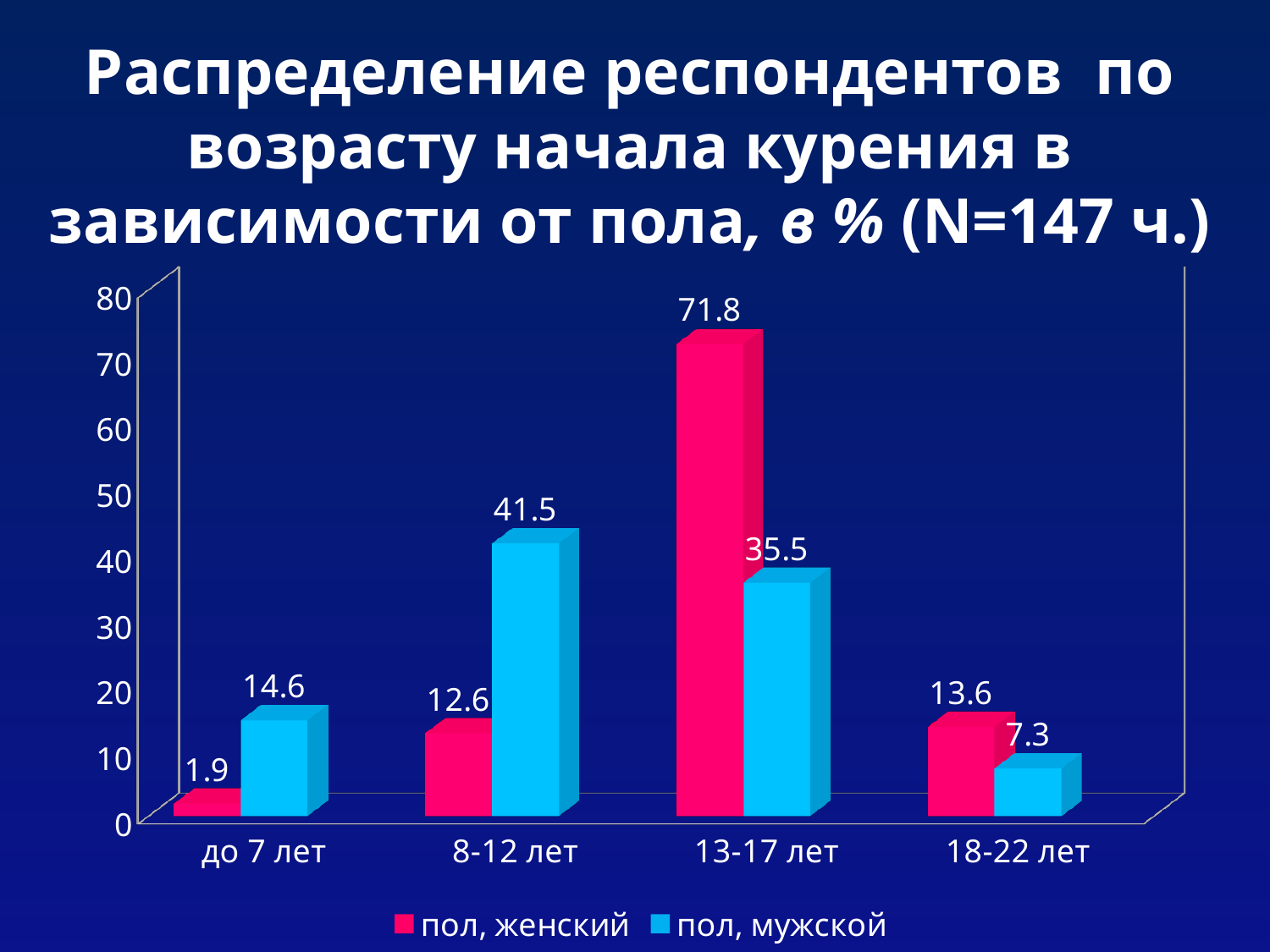
Which category has the highest value for 'пол, мужской'? 8-12 лет How many age categories are shown on the x axis? 4 What kind of chart is shown on the slide? bar chart What colour are the bars for 'пол, женский'? pink/red What is the value for 'пол, женский' in the 'до 7 лет' category? 1.9 What is the value for 'пол, женский' in the '13-17 лет' category? 71.8 What is the value for 'пол, мужской' in the '18-22 лет' category? 7.3 What is the difference between 'пол, женский' and 'пол, мужской' in the '13-17 лет' category? 36.3 Which category has the lowest value for 'пол, женский'? до 7 лет How many series does the legend list? 2 In the '8-12 лет' category, which series has the larger value, 'пол, женский' or 'пол, мужской'? пол, мужской What is the value for 'пол, мужской' in the '8-12 лет' category? 41.5